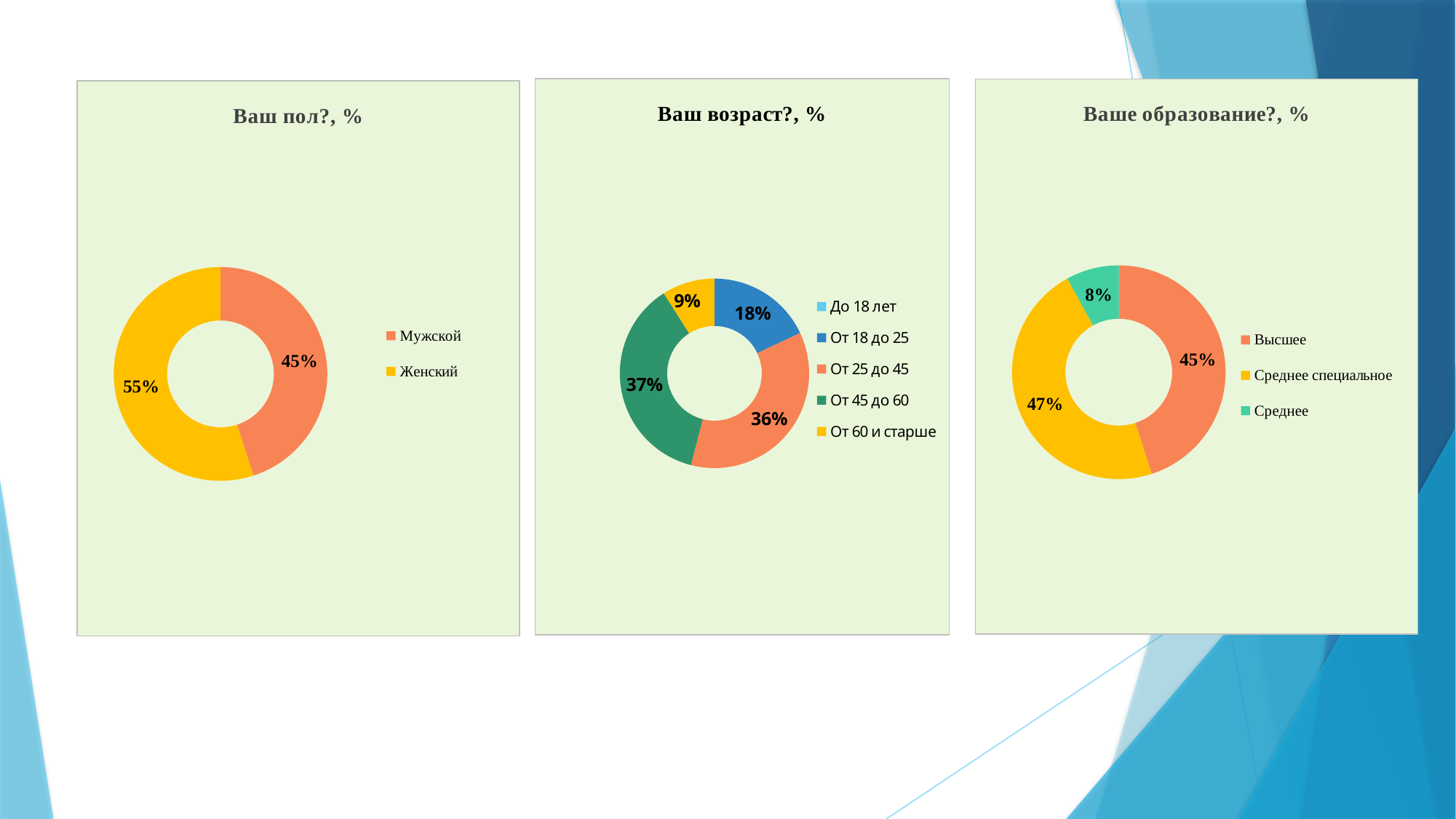
In the chart titled "Ваш пол?, %", what is the value for Женский? 55% In the chart titled "Ваш пол?, %", what is the value for Мужской? 45% In the chart titled "Ваш возраст?, %", what is the value for От 60 и старше? 9% In the chart titled "Ваше образование?, %", which is larger, Высшее or Среднее специальное? Среднее специальное In the chart titled "Ваше образование?, %", which category has the smallest share? Среднее In the chart titled "Ваш пол?, %", what is the difference between Женский and Мужской? 10% In the chart titled "Ваш возраст?, %", what is the difference between От 45 до 60 and От 18 до 25? 19% In the chart titled "Ваш возраст?, %", what is the value for От 25 до 45? 36% In the chart titled "Ваш возраст?, %", how many entries does the legend list? 5 In the chart titled "Ваше образование?, %", what is the value for Среднее специальное? 47% What type of chart is the chart titled "Ваш пол?, %"? Doughnut chart In the chart titled "Ваш возраст?, %", which category has the largest share? От 45 до 60